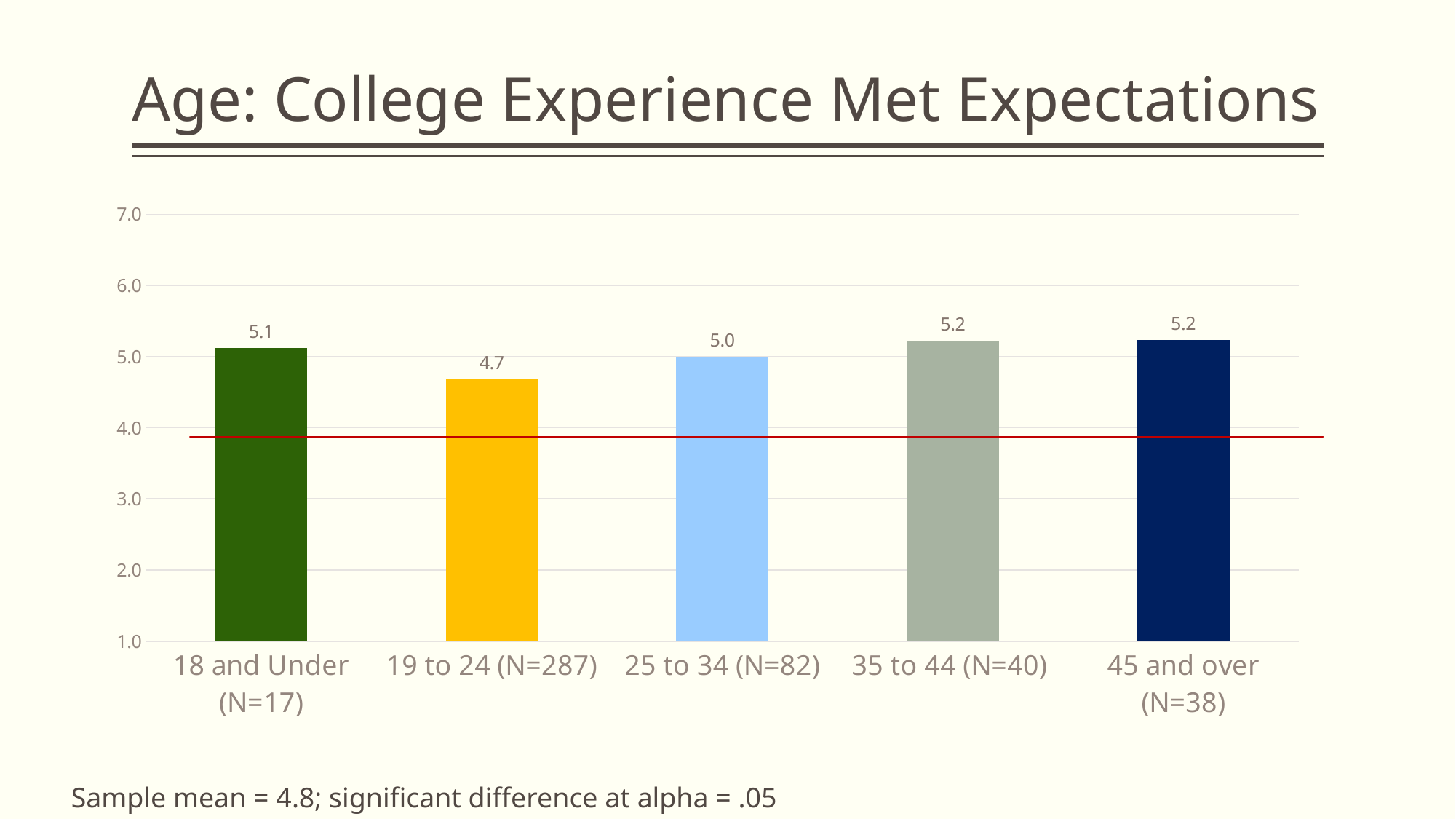
Which age group has the lowest value? 19 to 24 (N=287) What is the value for the 19 to 24 (N=287) age group? 4.7 What is the value for the 18 and Under (N=17) age group? 5.1 What is the value for the 25 to 34 (N=82) age group? 5.0 What is the difference between the values for 35 to 44 (N=40) and 19 to 24 (N=287)? 0.5 How many age groups are shown in the chart? 5 What is the difference between the values for 18 and Under (N=17) and 25 to 34 (N=82)? 0.1 Is the value for 19 to 24 (N=287) greater or less than 5.0? less What kind of chart is shown on the slide? bar chart What is the title of the slide? Age: College Experience Met Expectations What is the value for the 45 and over (N=38) age group? 5.2 Which is larger, the value for 18 and Under (N=17) or the value for 19 to 24 (N=287)? 18 and Under (N=17)